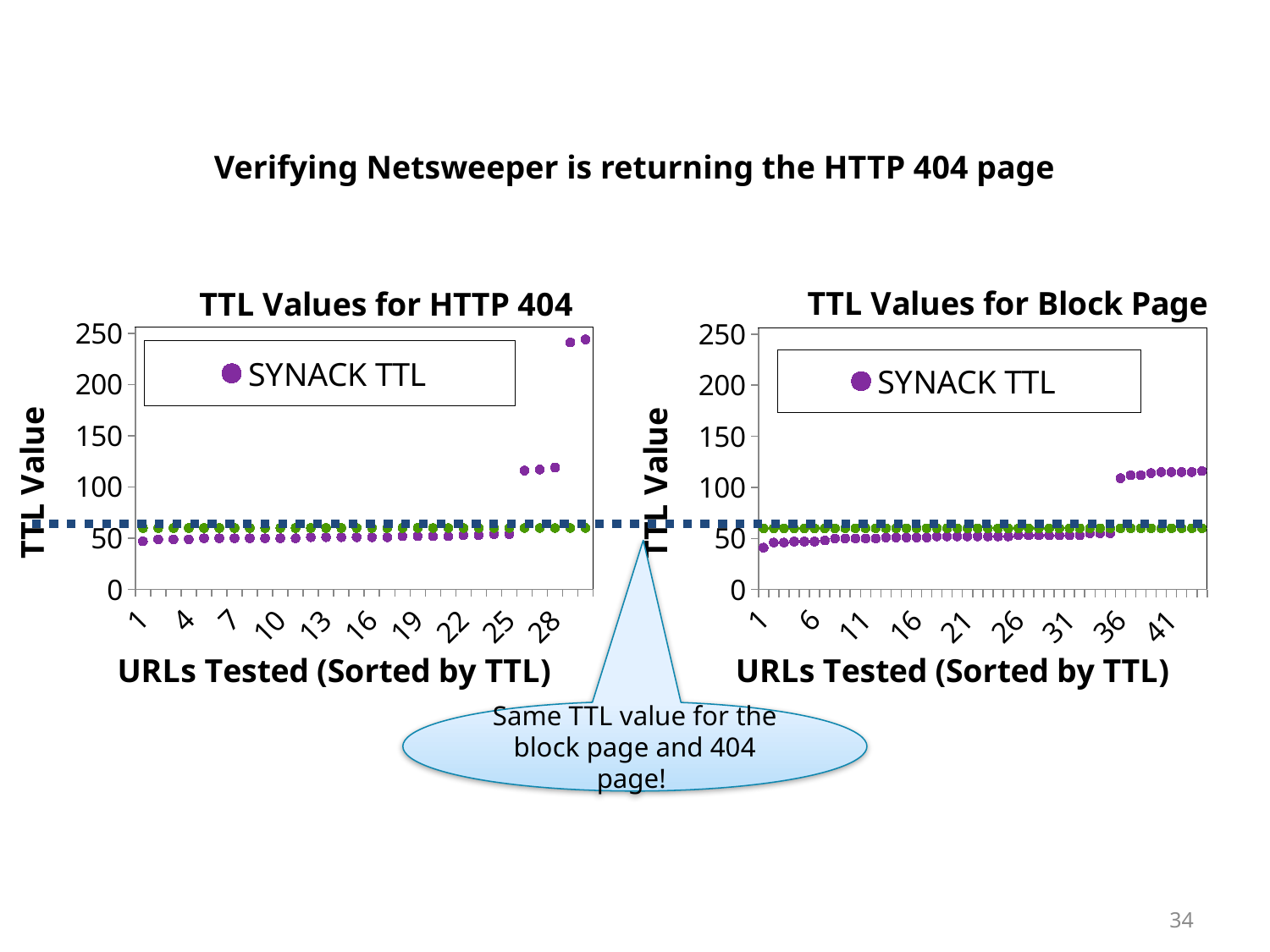
In the 'TTL Values for HTTP 404' chart, do the plotted values rise or fall along the x axis? rise How many series does the legend of the 'TTL Values for Block Page' chart list? 1 In the 'TTL Values for Block Page' chart, is the value for URL 41 greater or less than 100? greater In the 'TTL Values for HTTP 404' chart, what is the name of the series shown in the legend? SYNACK TTL What is the x-axis title of the 'TTL Values for Block Page' chart? URLs Tested (Sorted by TTL) Which chart has the higher maximum plotted SYNACK TTL value, 'TTL Values for HTTP 404' or 'TTL Values for Block Page'? TTL Values for HTTP 404 In the 'TTL Values for Block Page' chart, is the highest plotted SYNACK TTL value greater or less than 150? less What kind of chart is the 'TTL Values for HTTP 404' chart? scatter chart In the 'TTL Values for HTTP 404' chart, is the highest plotted SYNACK TTL value greater or less than 200? greater In the 'TTL Values for Block Page' chart, do the plotted values rise or fall along the x axis? rise